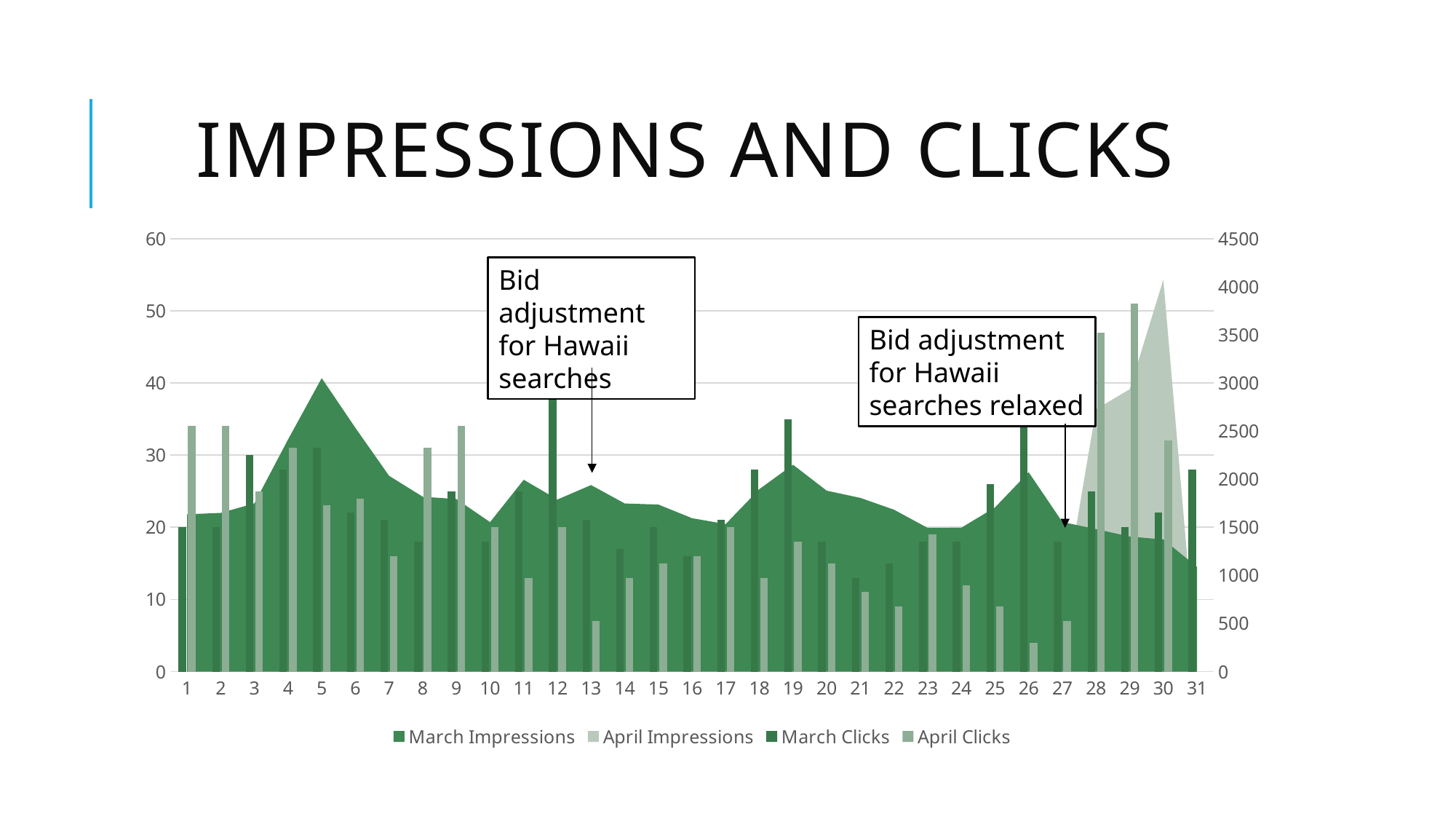
Is the March Clicks value on day 12 greater or less than 30? greater Is the April Clicks value on day 26 greater or less than 10? less Which is larger, the April Clicks value on day 1 or on day 26? Day 1 What kind of chart is this? Combination bar and area chart Does the March Impressions area rise or fall from day 5 to day 10? Fall What is the title of the chart? IMPRESSIONS AND CLICKS On which day is the April Clicks bar the shortest? 26 On which day is the March Clicks bar the tallest? 12 Which series are listed in the chart legend? March Impressions, April Impressions, March Clicks, April Clicks On which day is the April Clicks bar the tallest? 29 How many days are shown along the x axis of the chart? 31 How many series does the chart legend list? 4